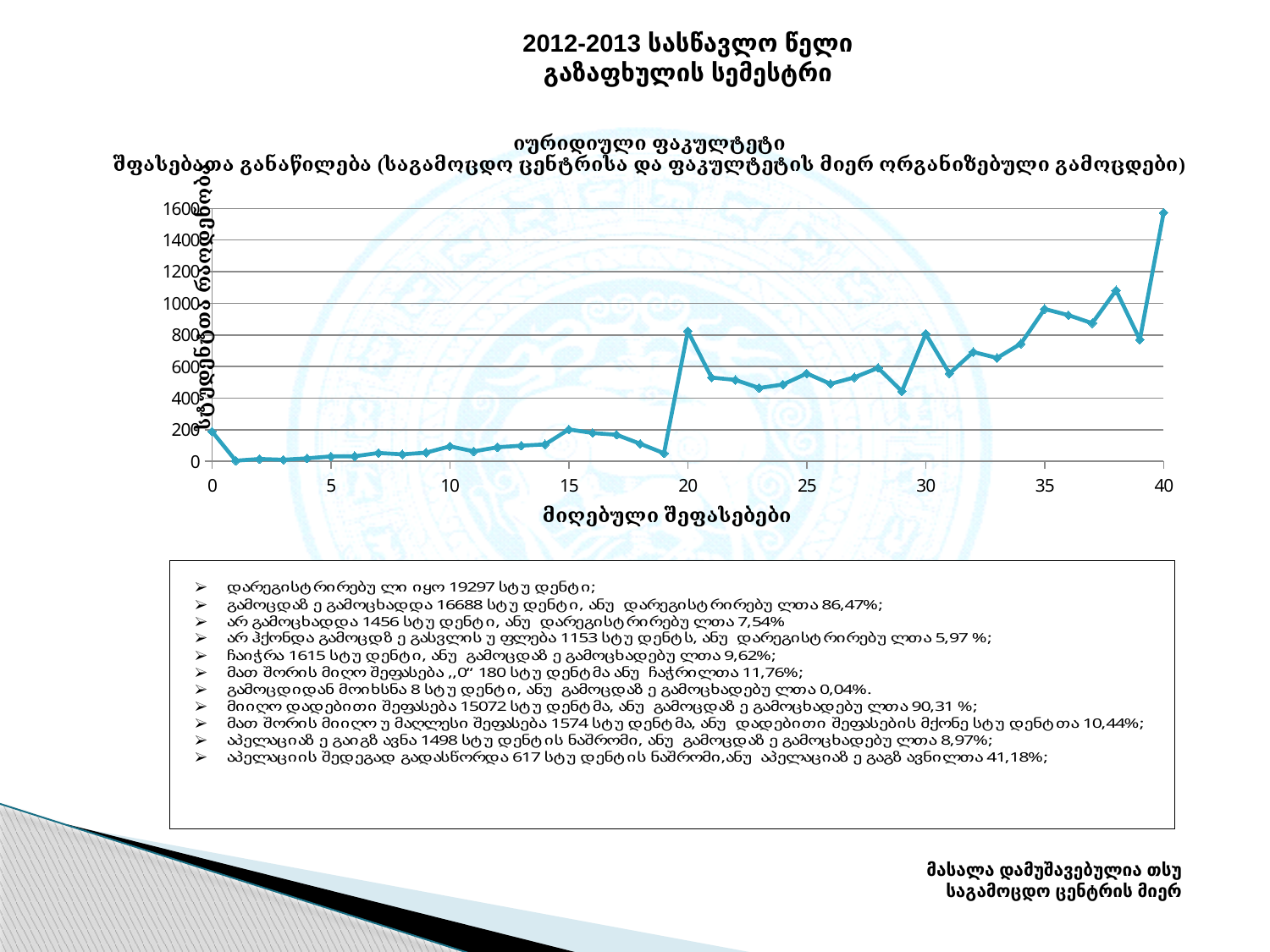
What kind of chart is shown on the slide? line chart Overall, do the values rise or fall as x increases from 20 to 40? rise What is the highest tick value shown on the y axis? 1600 Is the value at x = 40 greater or less than 1400? greater At which x-axis value does the line reach its highest point? 40 Is the value at x = 35 greater or less than 800? greater Which is larger, the value at x = 30 or the value at x = 29? x = 30 Is the value at x = 10 greater or less than 200? less Which is larger, the value at x = 20 or the value at x = 15? x = 20 What is the label on the x axis of the chart? მიღებული შეფასებები